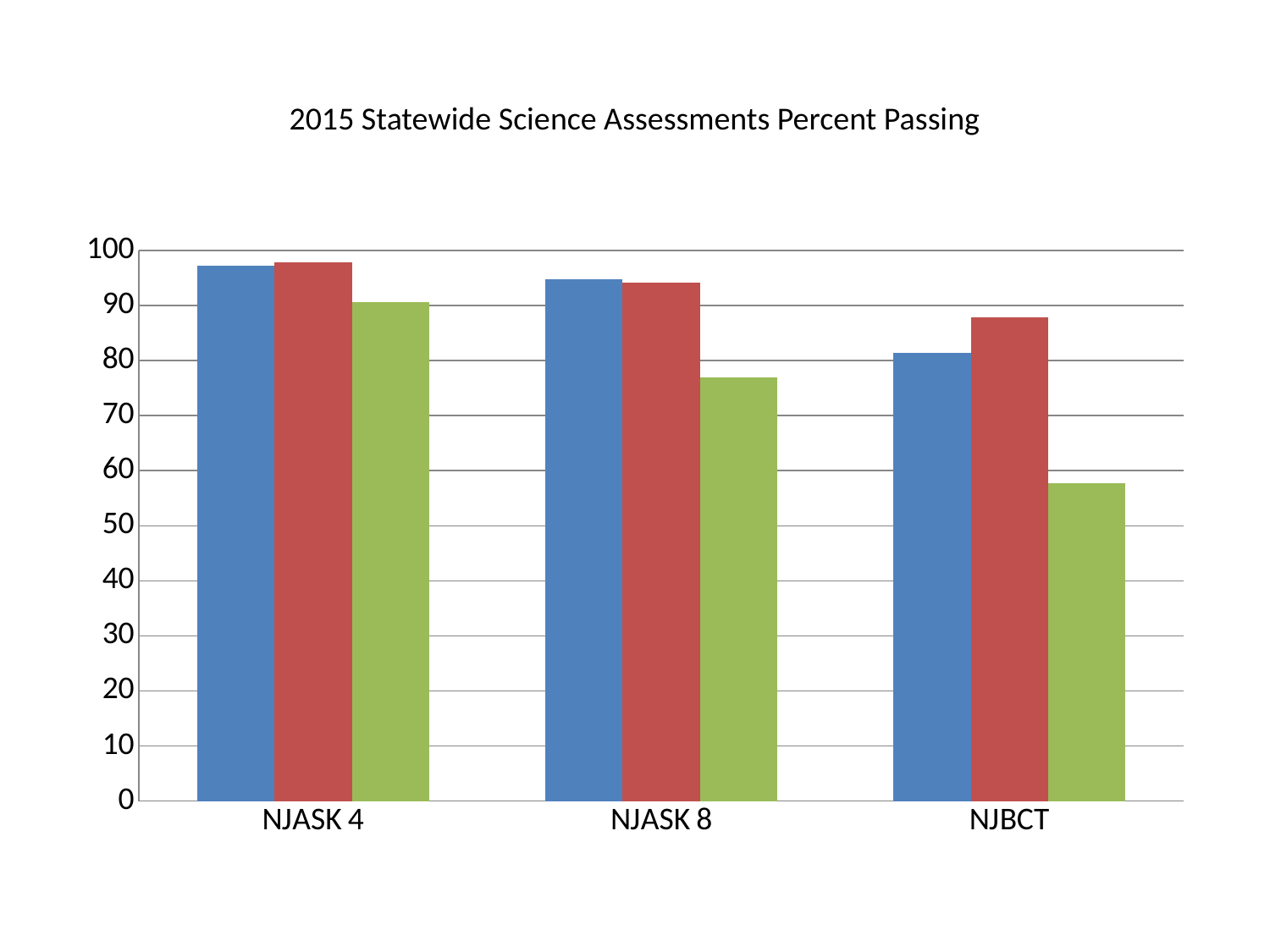
Is the value of the green bar for NJASK 4 greater or less than 80? greater Do the green bars rise or fall from NJASK 4 to NJBCT? fall How many categories are shown on the x axis? 3 Is the value of the green bar for NJBCT greater or less than 70? less Which category has the lowest green bar? NJBCT What is the title of the chart? 2015 Statewide Science Assessments Percent Passing Is the value of the green bar for NJASK 8 greater or less than 80? less For NJBCT, which bar is larger, the blue bar or the red bar? the red bar What kind of chart is shown on the slide? bar chart How many bars are shown for each category? 3